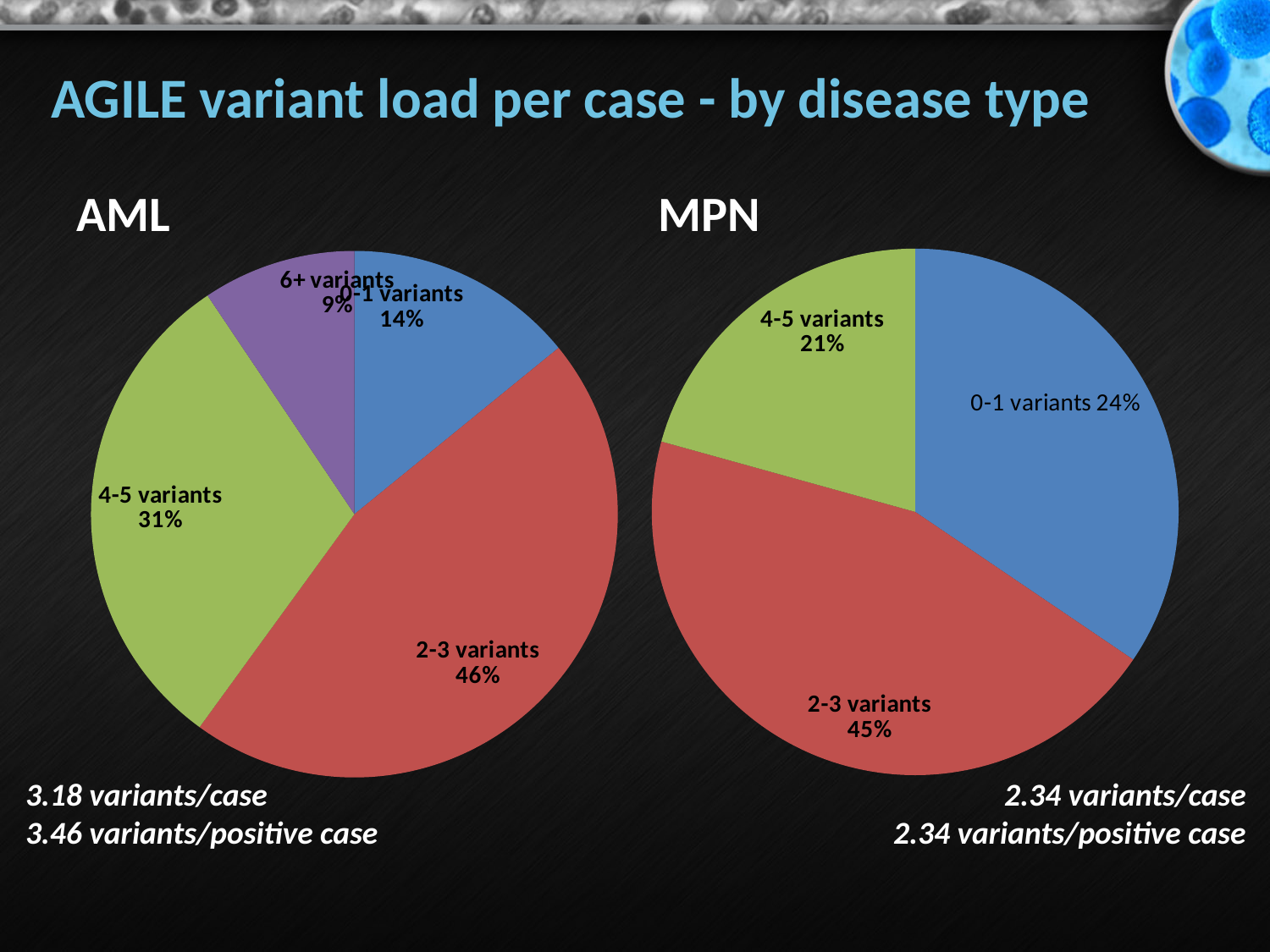
In the AML pie chart, which category has the largest share? 2-3 variants How many slices does the AML pie chart have? 4 In the AML pie chart, what share of cases have 6+ variants? 9% In the AML pie chart, what is the difference between the 4-5 variants share and the 0-1 variants share? 17% In the MPN pie chart, which category has the smallest share? 4-5 variants Which is larger in the MPN pie chart: the 0-1 variants share or the 4-5 variants share? 0-1 variants What type of chart is used for the AML and MPN data? Pie chart In the AML pie chart, what share of cases have 2-3 variants? 46% In the AML pie chart, which category has the smallest share? 6+ variants In the MPN pie chart, what share of cases have 4-5 variants? 21% How many slices does the MPN pie chart have? 3 In the MPN pie chart, what share of cases have 0-1 variants? 24%